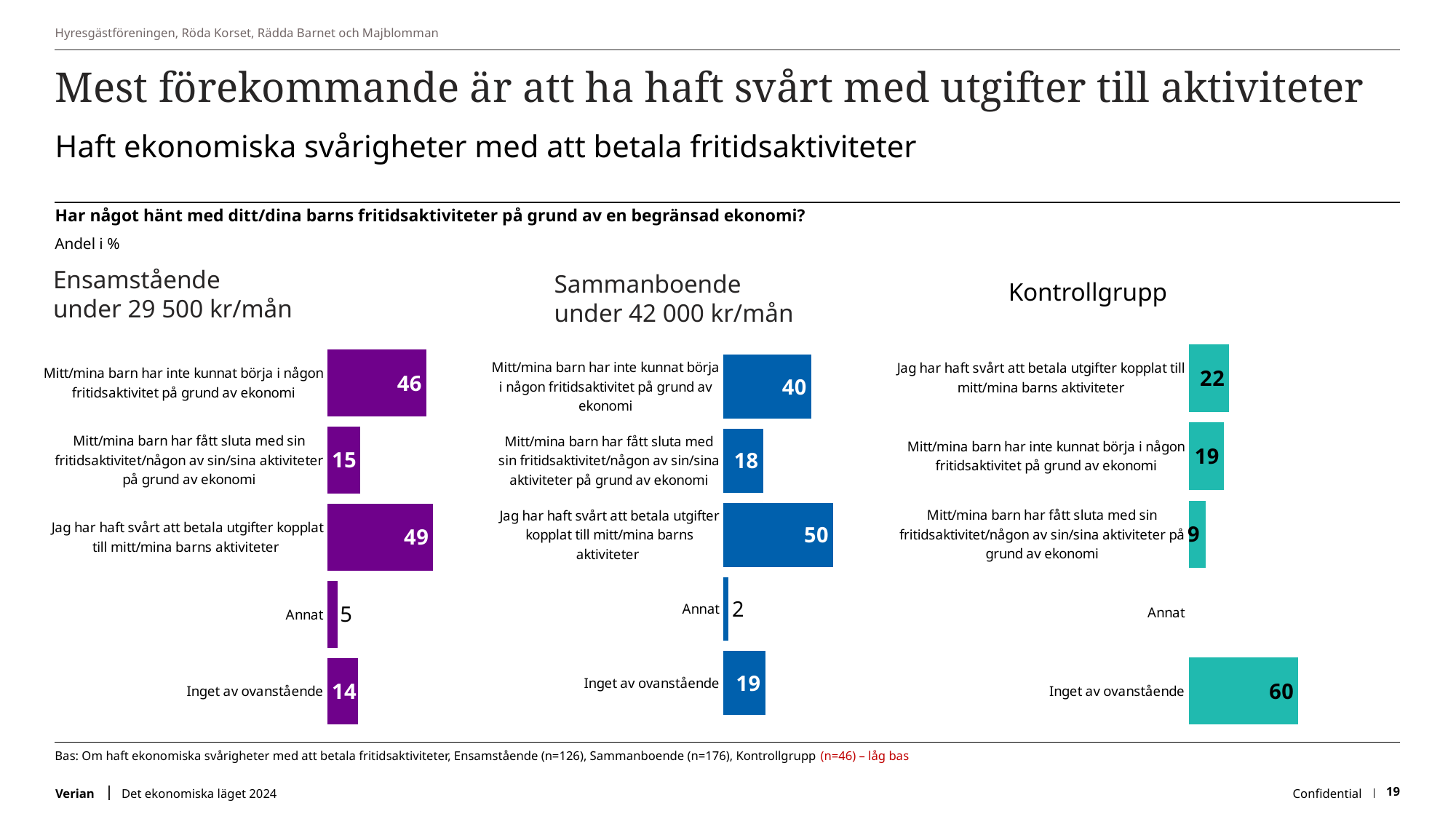
In the Ensamstående under 29 500 kr/mån chart, what is the difference between "Mitt/mina barn har inte kunnat börja i någon fritidsaktivitet på grund av ekonomi" and "Mitt/mina barn har fått sluta med sin fritidsaktivitet/någon av sin/sina aktiviteter på grund av ekonomi"? 31 What colour are the bars in the Sammanboende under 42 000 kr/mån chart? Blue In the Sammanboende under 42 000 kr/mån chart, what is the value for "Annat"? 2 In the Ensamstående under 29 500 kr/mån chart, which category has the lowest value? Annat In the Sammanboende under 42 000 kr/mån chart, which category has the highest value? Jag har haft svårt att betala utgifter kopplat till mitt/mina barns aktiviteter How many categories are shown in the Ensamstående under 29 500 kr/mån chart? 5 In the Kontrollgrupp chart, what is the value for "Inget av ovanstående"? 60 In the Sammanboende under 42 000 kr/mån chart, what is the value for "Mitt/mina barn har fått sluta med sin fritidsaktivitet/någon av sin/sina aktiviteter på grund av ekonomi"? 18 In the Ensamstående under 29 500 kr/mån chart, what is the value for "Jag har haft svårt att betala utgifter kopplat till mitt/mina barns aktiviteter"? 49 Which is larger: the value for "Inget av ovanstående" in the Sammanboende chart or in the Ensamstående chart? Sammanboende What kind of chart is the Kontrollgrupp chart? Bar chart In the Kontrollgrupp chart, what is the difference between "Inget av ovanstående" and "Jag har haft svårt att betala utgifter kopplat till mitt/mina barns aktiviteter"? 38